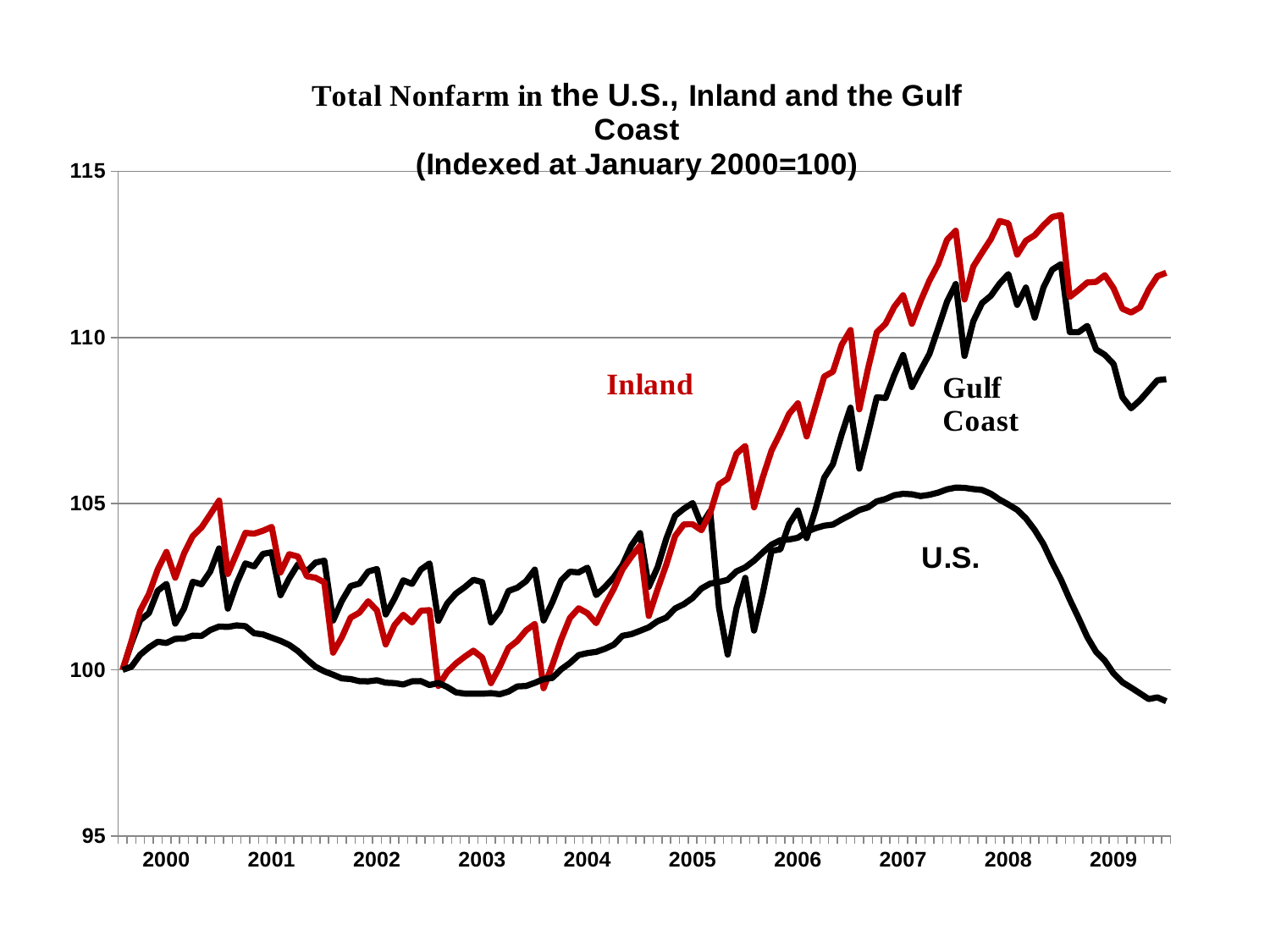
What is the index base stated in the chart title? January 2000=100 How many series are plotted on the chart? 3 Which series is plotted in red? Inland Which series has the lowest value at the end of 2009? U.S. Is the value for Gulf Coast at the end of 2009 greater or less than 105? greater Which series has the highest value at the end of 2009? Inland What kind of chart is shown on the slide? line chart Is the highest value reached by the U.S. series greater or less than 110? less Does the U.S. series rise or fall from 2008 to 2009? fall Does the Inland series rise or fall from 2005 to 2007? rise Is the value for U.S. at the end of 2009 greater or less than 100? less